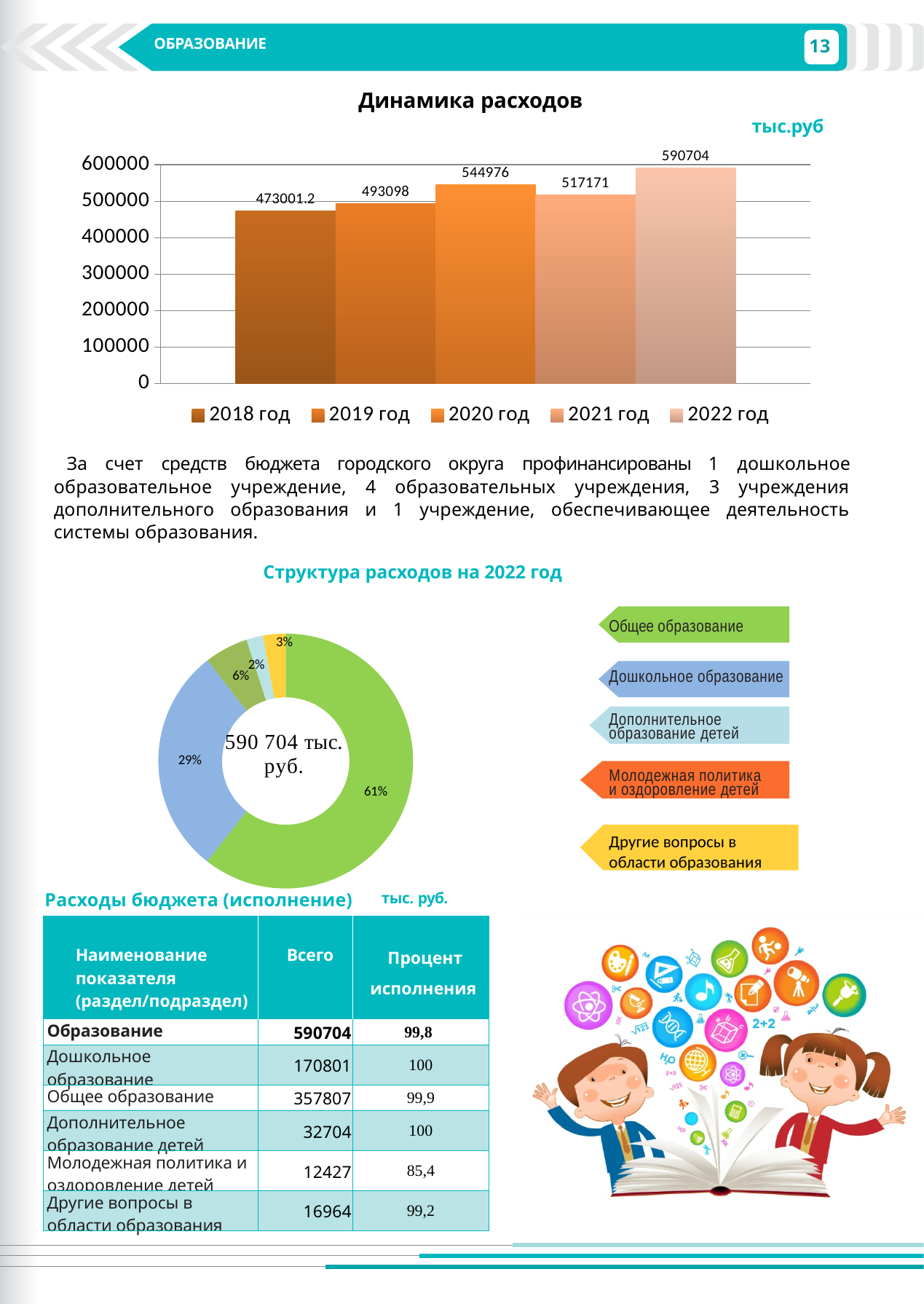
In the 'Динамика расходов' chart, which year has the highest value? 2022 год In the 'Динамика расходов' chart, which is larger: the value for 2020 год or 2021 год? 2020 год In the 'Структура расходов на 2022 год' chart, what total amount is written in the centre of the donut? 590 704 тыс. руб. In the 'Динамика расходов' chart, what is the value for 2020 год? 544976 In the 'Структура расходов на 2022 год' chart, what share does the largest slice (Общее образование) have? 61% In the 'Динамика расходов' chart, which year has the lowest value? 2018 год In the 'Динамика расходов' chart, how many years are plotted? 5 In the 'Структура расходов на 2022 год' chart, what share does the blue slice (Дошкольное образование) have? 29% In the 'Динамика расходов' chart, what unit is shown above the chart? тыс.руб In the 'Динамика расходов' chart, what is the difference between the values for 2022 год and 2021 год? 73533 What kind of chart is 'Динамика расходов'? bar chart In the 'Динамика расходов' chart, what is the value for 2018 год? 473001.2